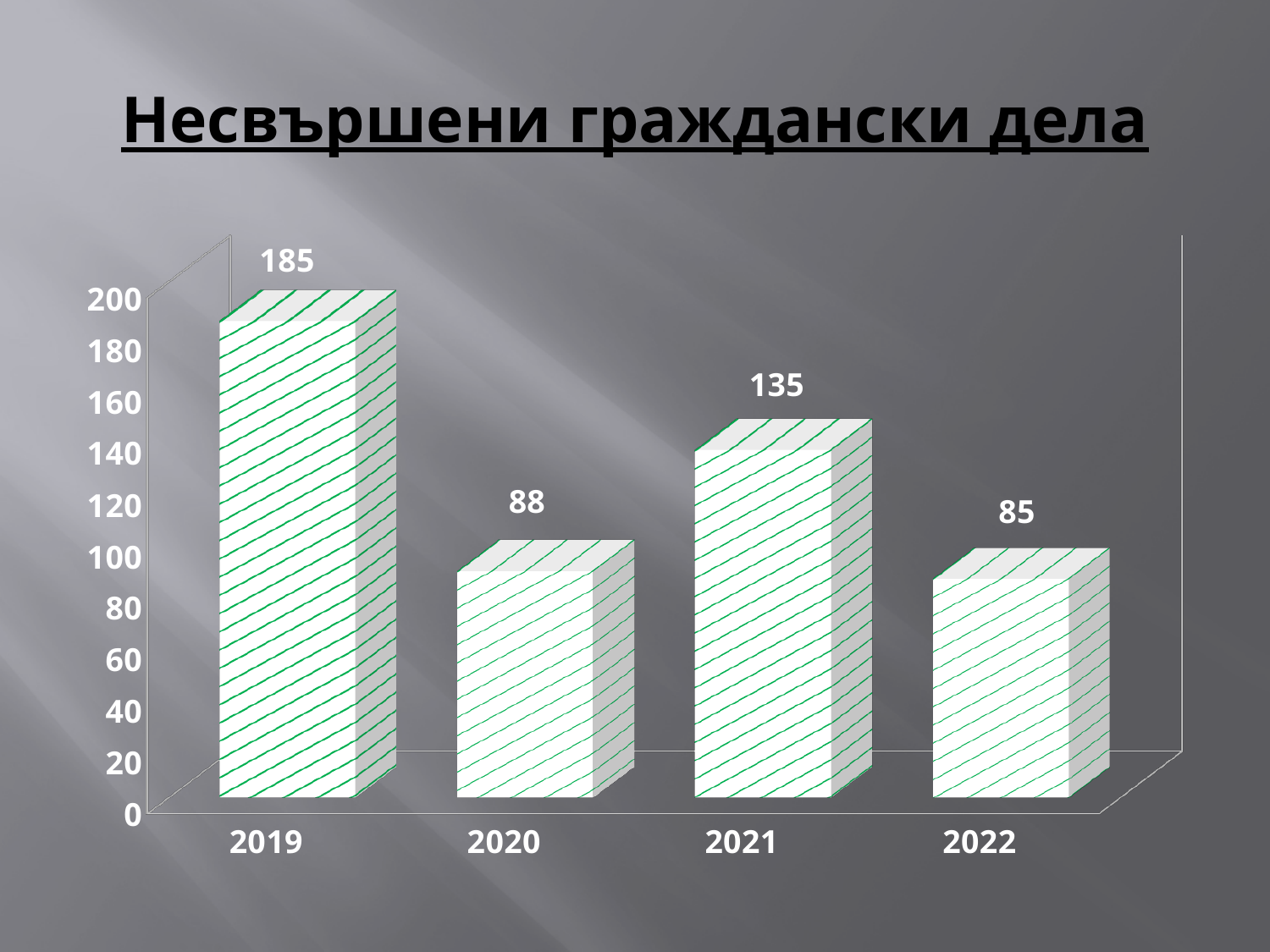
What kind of chart is shown on the slide? bar chart Which is larger, the value for 2020 or the value for 2021? 2021 What is the value for 2021? 135 Which year has the lowest value? 2022 What is the value for 2022? 85 How many years are shown on the chart? 4 What is the difference between the values for 2019 and 2021? 50 What is the difference between the values for 2020 and 2022? 3 What is the title of the chart? Несвършени граждански дела What is the value for 2020? 88 Which year has the highest value? 2019 What is the value for 2019? 185